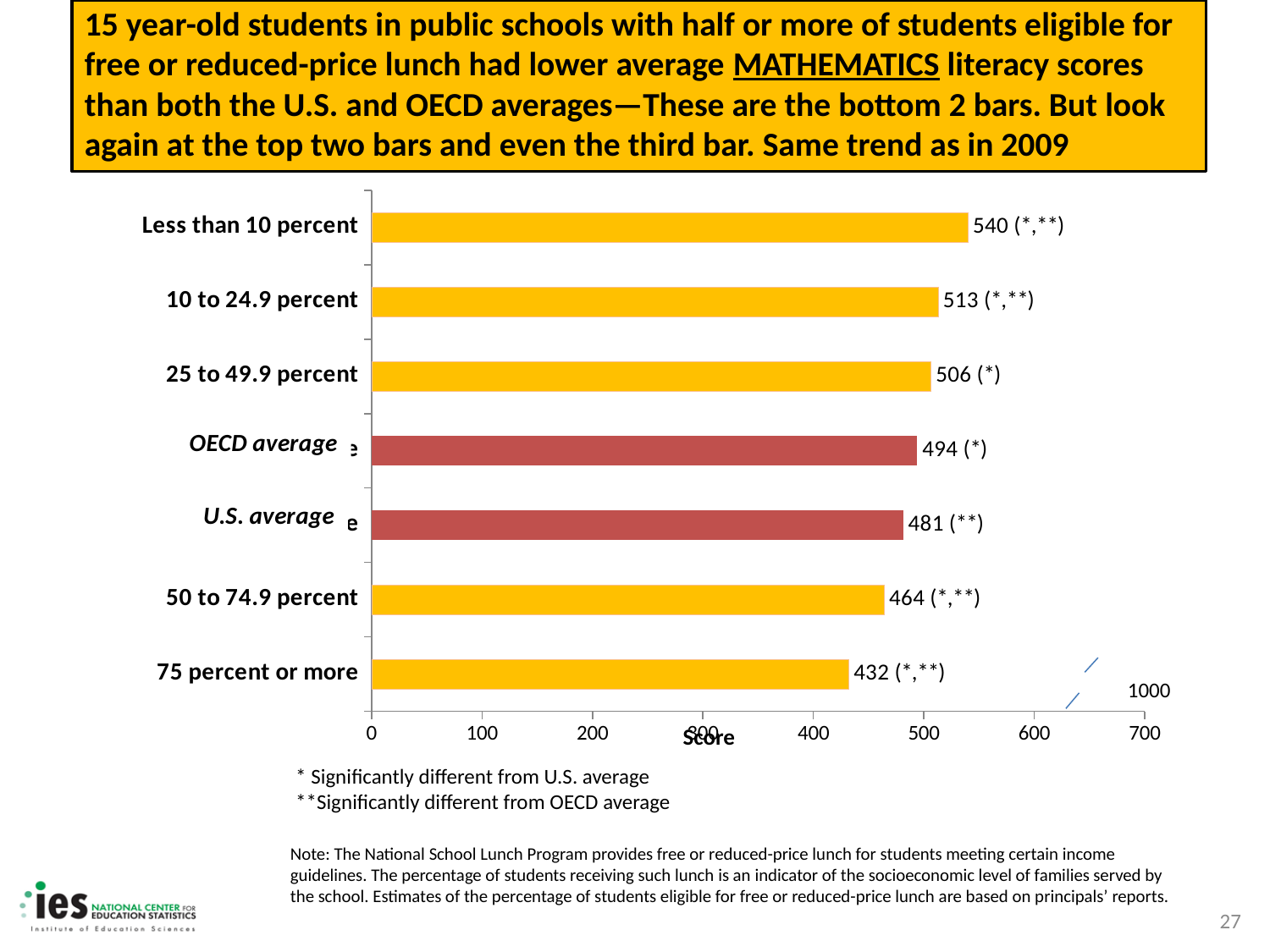
What is the difference between the OECD average and the U.S. average scores? 13 What is the score shown for the 75 percent or more category? 432 What is the OECD average score shown on the chart? 494 What kind of chart is shown on the slide? Bar chart How many bars are shown on the chart? 7 Which category has the lowest score? 75 percent or more What is the average mathematics literacy score for students in schools with less than 10 percent eligible for free or reduced-price lunch? 540 Which is larger, the score for 50 to 74.9 percent or the U.S. average? U.S. average What is the U.S. average score shown on the chart? 481 What is the label of the horizontal axis? Score Which category has the highest score? Less than 10 percent What is the difference between the score for less than 10 percent and the score for 75 percent or more? 108